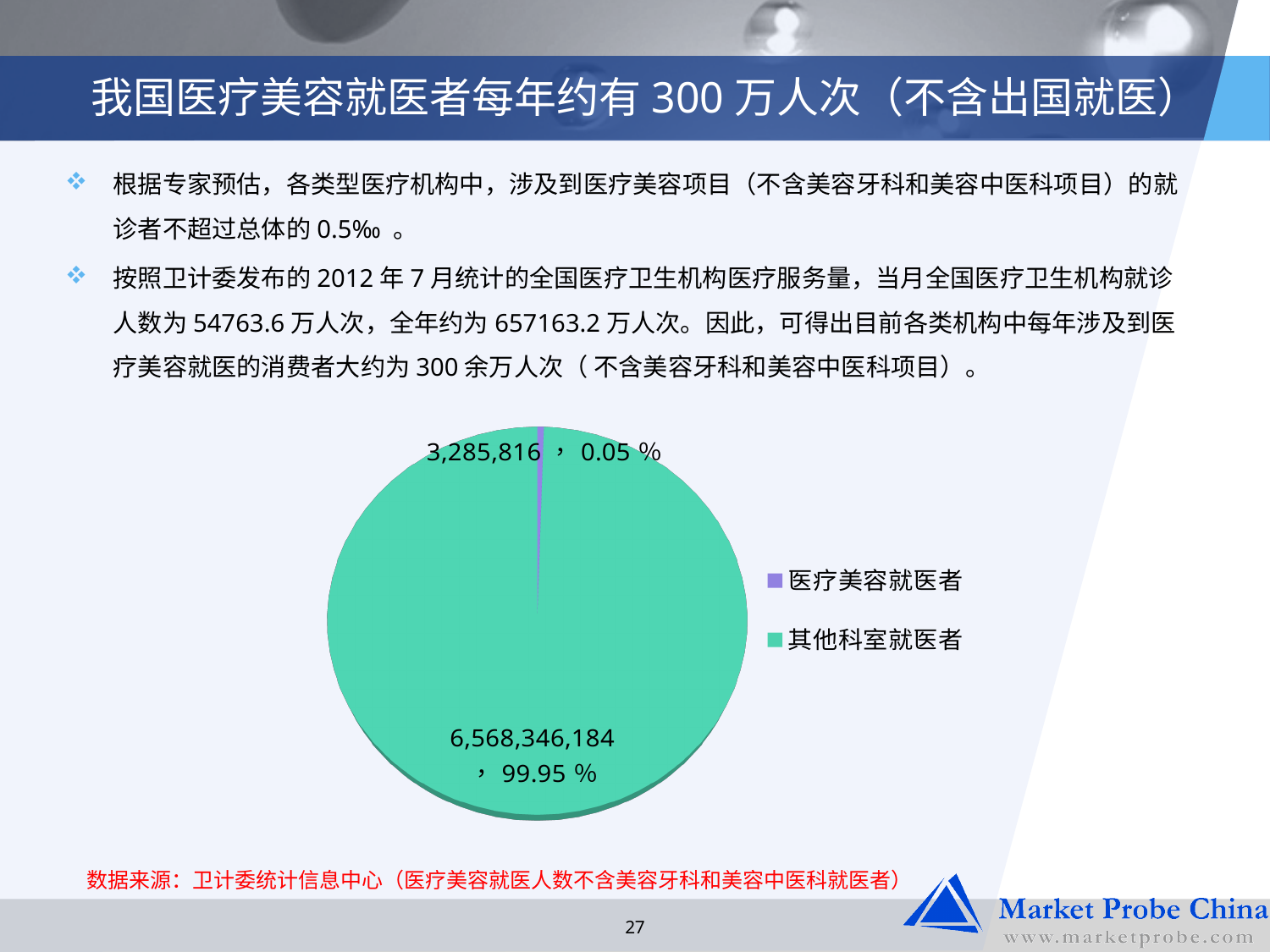
What value is shown for 医疗美容就医者 in the pie chart? 3,285,816 How many slices does the pie chart have? 2 What is the total of the two values shown in the pie chart? 6,571,632,000 What share of the pie does 医疗美容就医者 represent? 0.05 % Which category has the largest slice in the pie chart? 其他科室就医者 What share of the pie does 其他科室就医者 represent? 99.95 % Which is larger, the value for 医疗美容就医者 or the value for 其他科室就医者? 其他科室就医者 What value is shown for 其他科室就医者 in the pie chart? 6,568,346,184 What kind of chart is shown on the slide? pie chart How many entries does the chart legend list? 2 Which category has the smallest slice in the pie chart? 医疗美容就医者 What is the difference between the values for 其他科室就医者 and 医疗美容就医者? 6,565,060,368